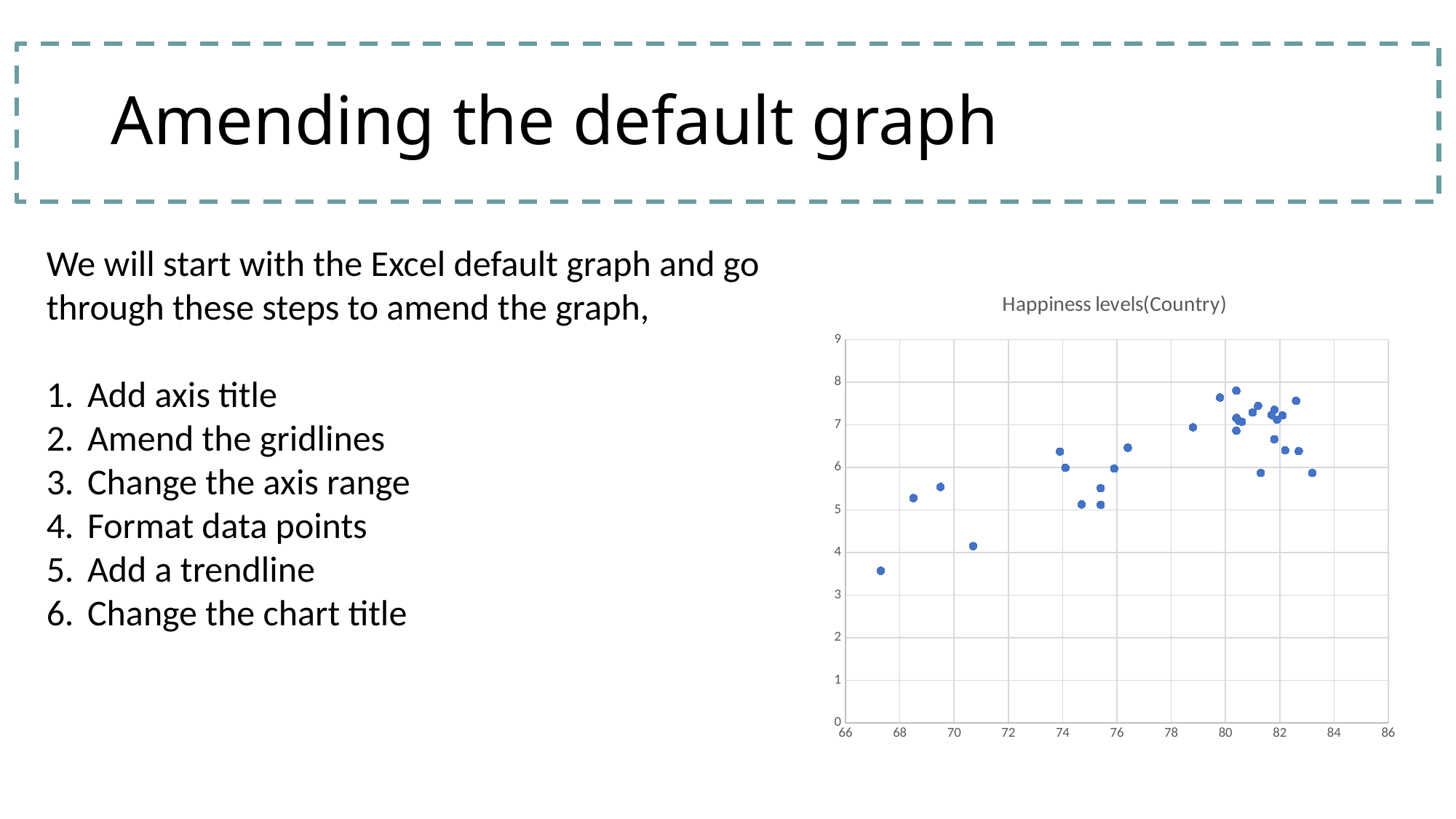
What is the title of the chart on the slide? Happiness levels(Country) What kind of chart is shown on the slide? Scatter chart Do the plotted values generally rise or fall as the x-axis value increases? Rise Is the y value of the leftmost point in the chart greater or less than 4? less Are any points in the chart plotted below a y value of 3? No Is the x value of the lowest point in the chart greater or less than 68? less What are the minimum and maximum values shown on the x axis of the chart? 66 and 86